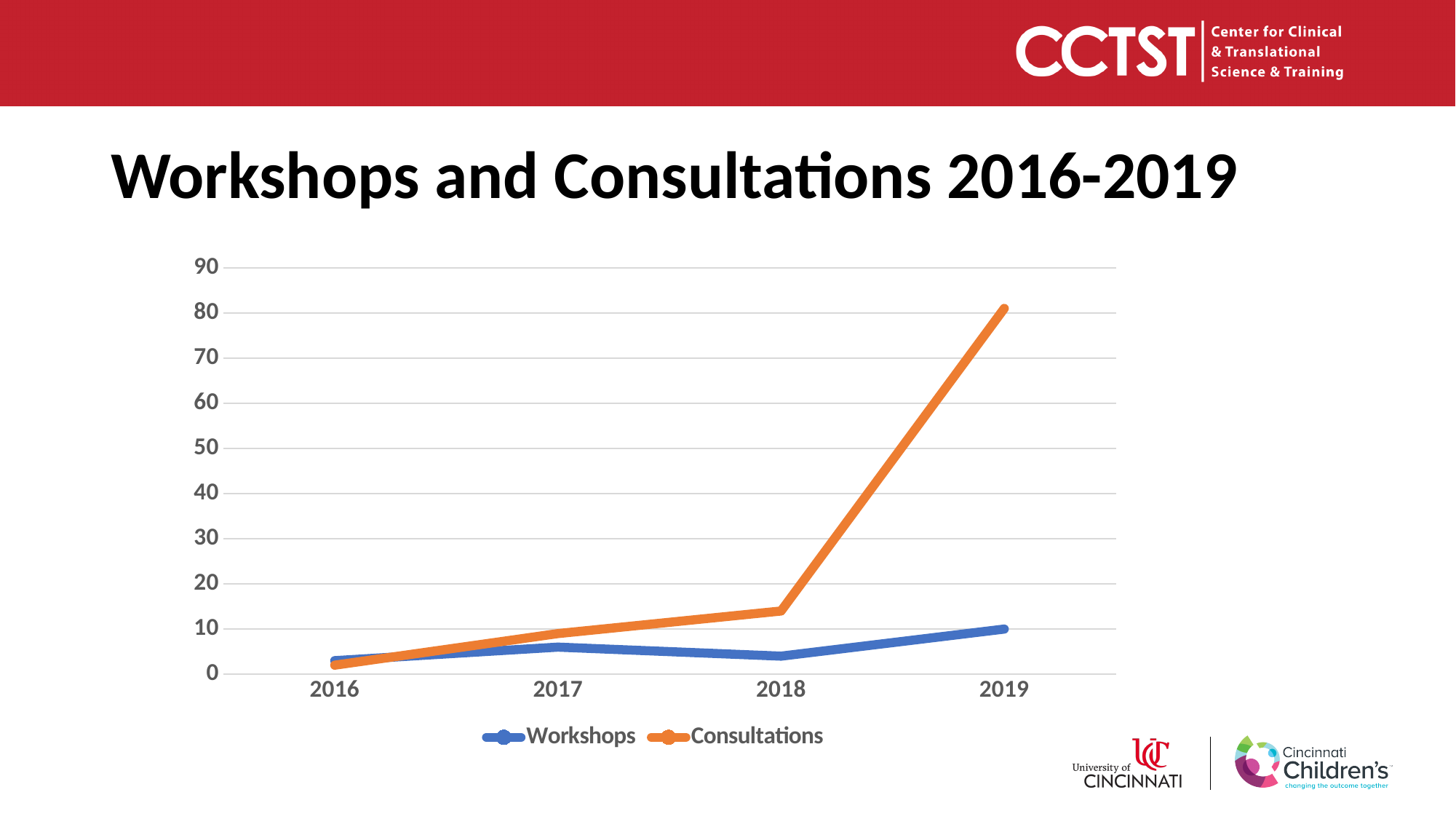
In which year is the Consultations value highest? 2019 Is the Consultations value for 2019 greater or less than 70? greater Which colour represents the Consultations series in the legend? Orange How many years are plotted along the x axis? 4 Do the Consultations values rise or fall from 2016 to 2019? Rise How many series does the legend list? 2 What kind of chart is shown on the slide? Line chart In 2019, which series has the larger value, Workshops or Consultations? Consultations Is the Workshops value for 2019 greater or less than 20? less In which year is the Workshops value highest? 2019 Is the Consultations value for 2018 greater or less than 20? less In which year is the Consultations value lowest? 2016